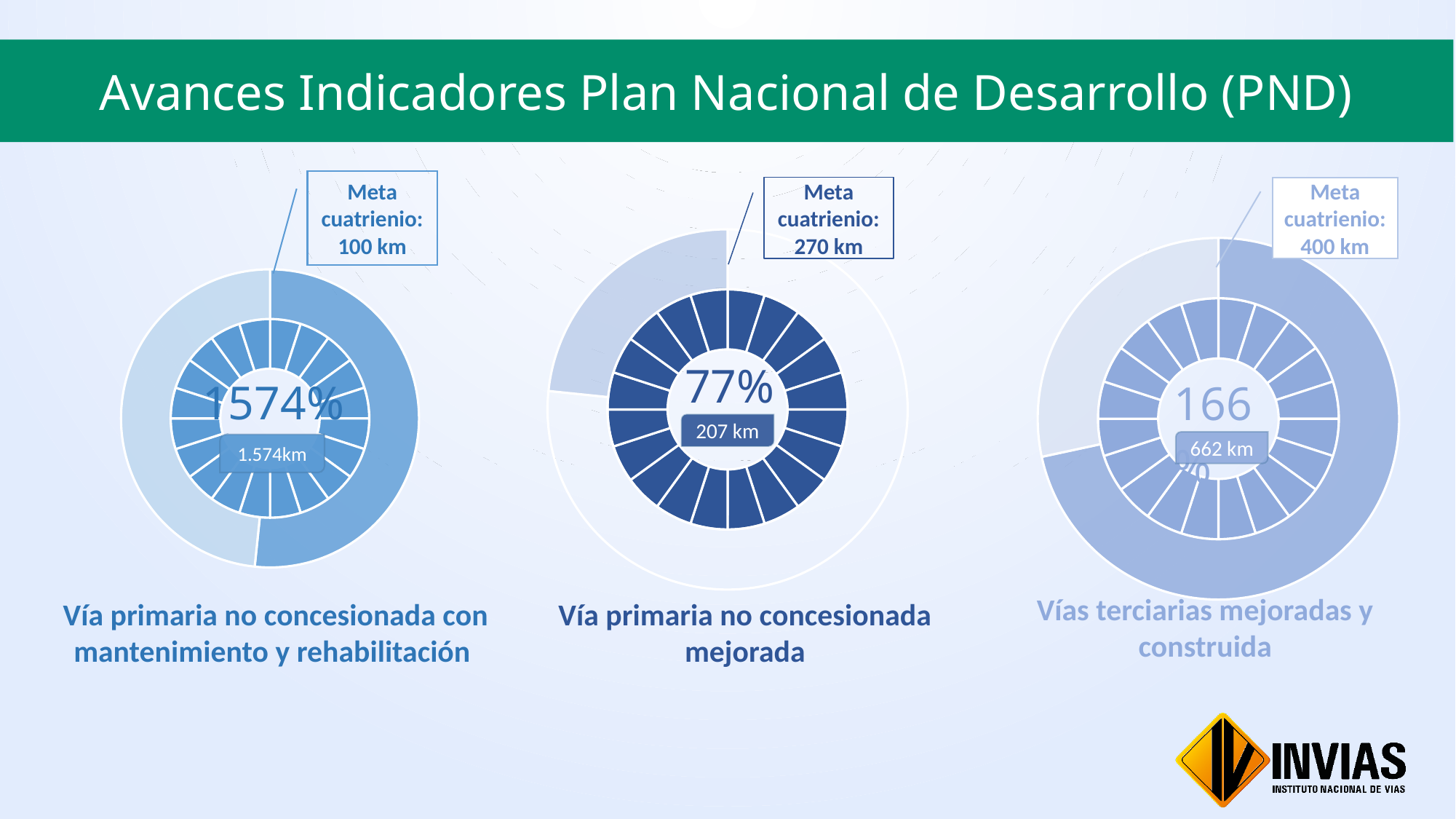
What is the "Meta cuatrienio" for the chart titled "Vía primaria no concesionada mejorada"? 270 km Which of the three charts shows the highest percentage of progress? Vía primaria no concesionada con mantenimiento y rehabilitación What percentage is shown in the centre of the chart titled "Vía primaria no concesionada mejorada"? 77% For the chart titled "Vía primaria no concesionada mejorada", how many kilometres short of the Meta cuatrienio is the achieved value? 63 km What percentage is shown in the centre of the chart titled "Vía primaria no concesionada con mantenimiento y rehabilitación"? 1574% For the chart titled "Vías terciarias mejoradas y construida", by how many kilometres does the achieved value exceed the Meta cuatrienio? 262 km How many kilometres are shown for the chart titled "Vía primaria no concesionada mejorada"? 207 km Which of the three charts shows the lowest percentage of progress? Vía primaria no concesionada mejorada How many charts are shown on the slide? 3 What is the "Meta cuatrienio" for the chart titled "Vías terciarias mejoradas y construida"? 400 km What is the "Meta cuatrienio" for the chart titled "Vía primaria no concesionada con mantenimiento y rehabilitación"? 100 km How many kilometres are shown for the chart titled "Vías terciarias mejoradas y construida"? 662 km